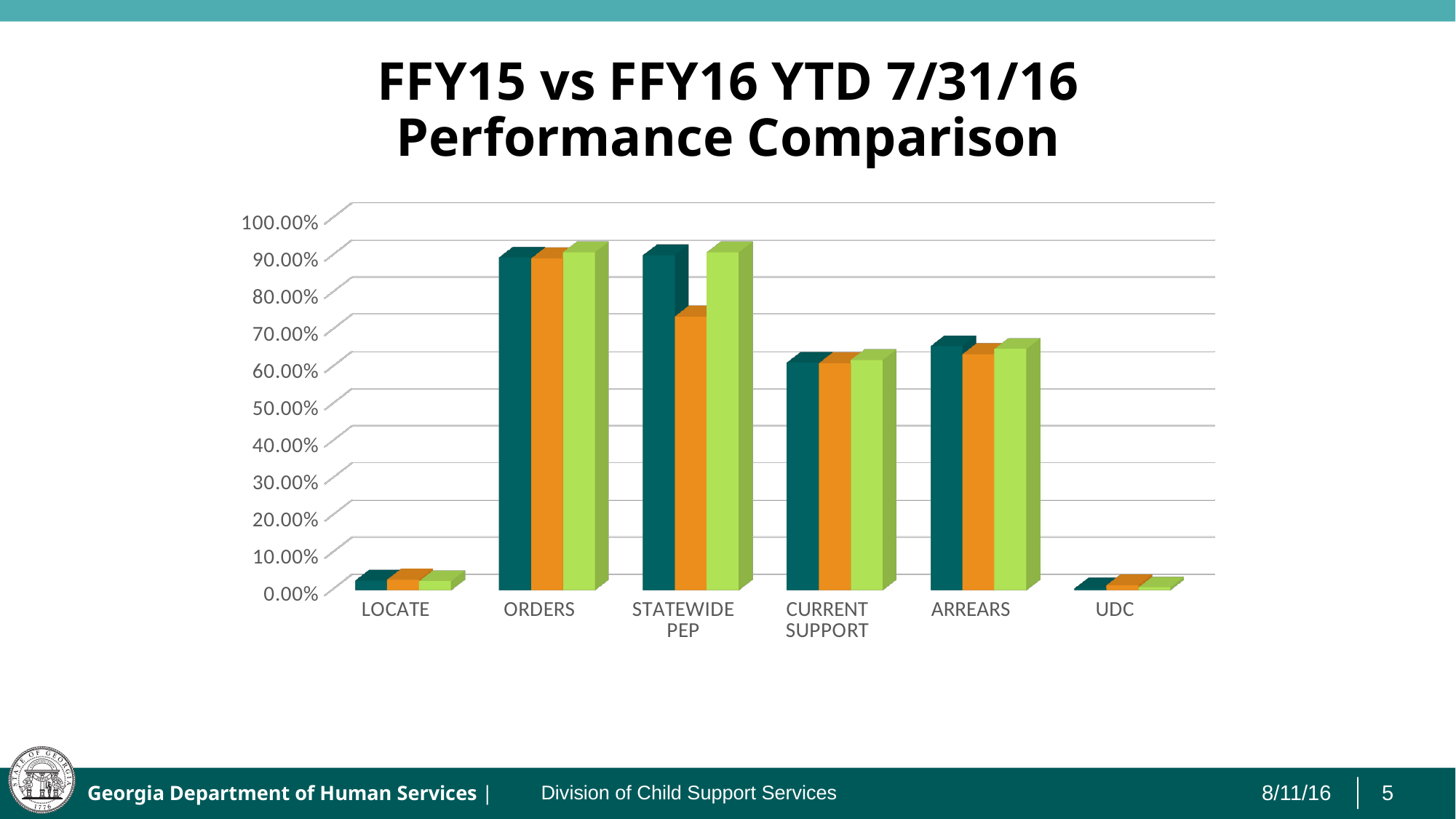
Which has the larger first (dark teal) bar, ARREARS or CURRENT SUPPORT? ARREARS What is the title of the slide containing the chart? FFY15 vs FFY16 YTD 7/31/16 Performance Comparison Is the first (dark teal) bar for ORDERS greater or less than 80.00%? greater Is the first (dark teal) bar for CURRENT SUPPORT greater or less than 50.00%? greater Is the middle (orange) bar for STATEWIDE PEP greater or less than 80.00%? less Which has the larger middle (orange) bar, ORDERS or STATEWIDE PEP? ORDERS What kind of chart is shown on the slide? bar chart How many bars are plotted for each category in the chart? 3 How many categories are shown on the x axis of the chart? 6